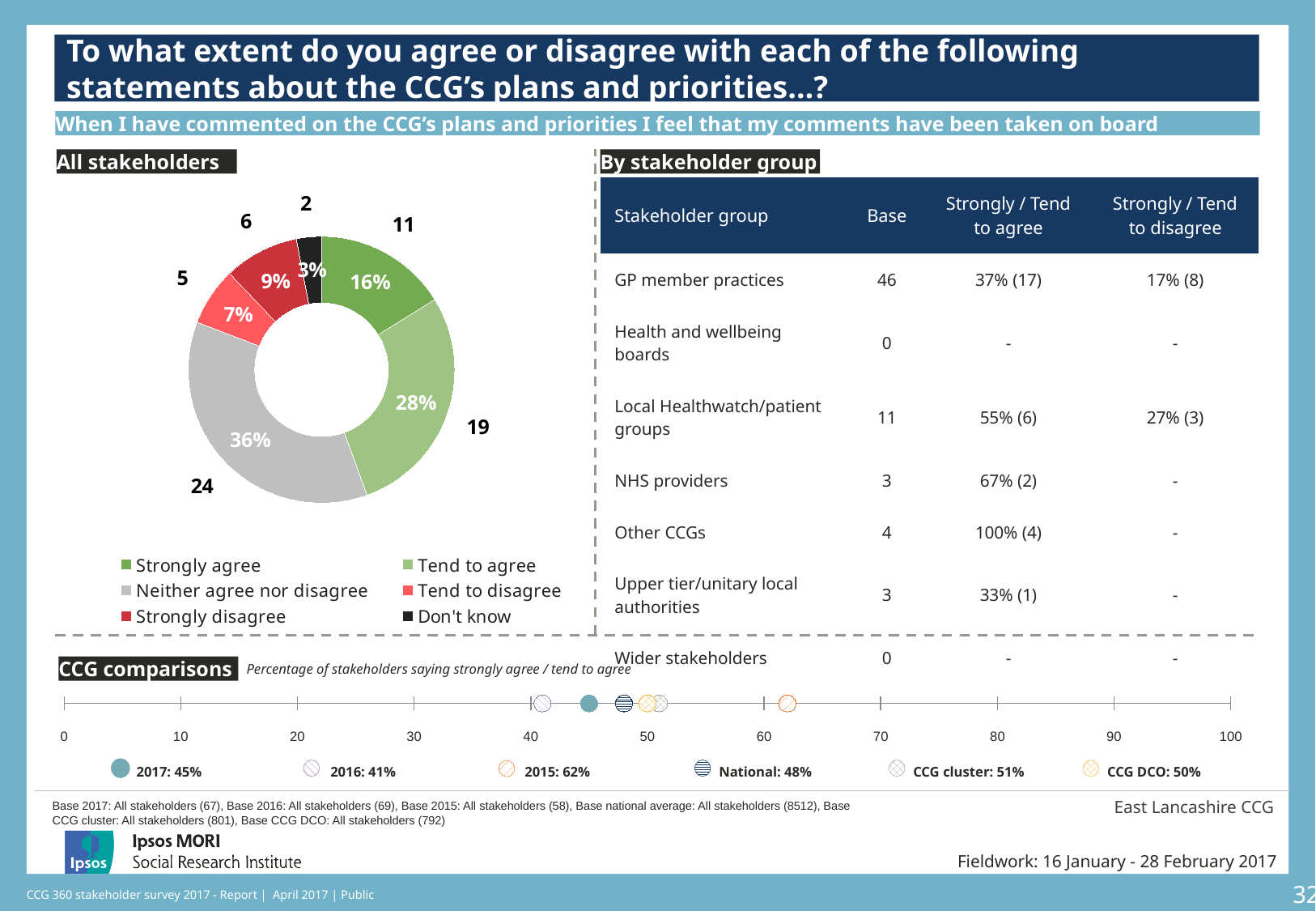
In the 'All stakeholders' donut chart, what percentage of stakeholders said 'Tend to agree'? 28% How many response categories does the legend of the 'All stakeholders' donut chart list? 6 In the 'All stakeholders' donut chart, which response category has the smallest share? Don't know In the 'All stakeholders' donut chart, which response category has the largest share? Neither agree nor disagree In the 'All stakeholders' donut chart, how many stakeholders said 'Strongly agree'? 11 In the 'CCG comparisons' chart, what is the difference in percentage points between the 2017 value and the 2016 value? 4 What type of chart is used in the 'All stakeholders' section? Donut (pie) chart In the 'CCG comparisons' chart, what is the 2017 percentage of stakeholders saying strongly agree / tend to agree? 45% In the 'All stakeholders' donut chart, what is the difference in percentage points between 'Tend to agree' and 'Strongly agree'? 12 In the 'CCG comparisons' chart, which comparison point has the highest value? 2015: 62% In the 'All stakeholders' donut chart, what percentage of stakeholders said 'Neither agree nor disagree'? 36% In the 'All stakeholders' donut chart, which is larger: the share for 'Strongly disagree' or the share for 'Tend to disagree'? Strongly disagree